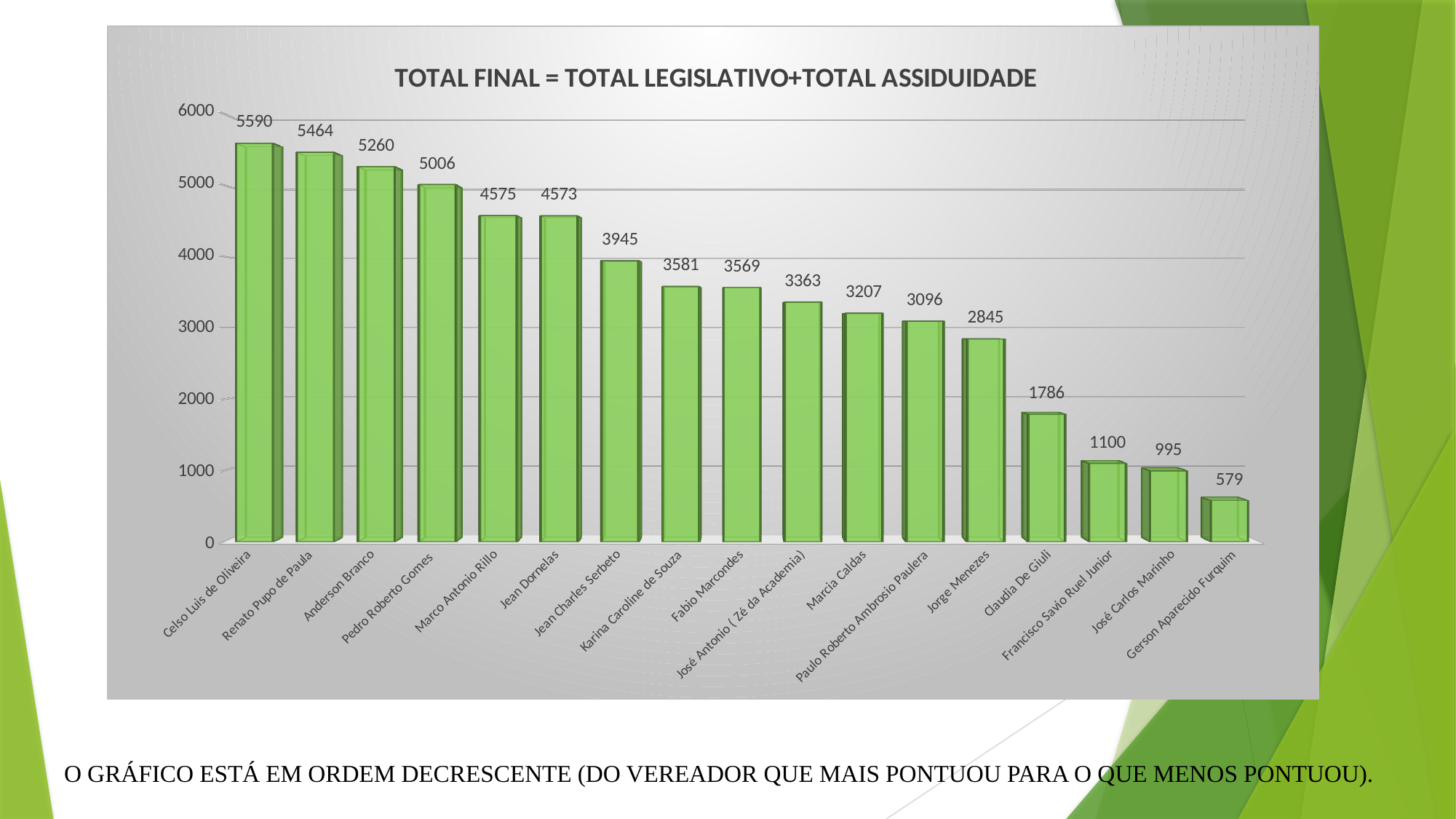
What is the value for Claudia De Giuli? 1786 What kind of chart is shown on the slide? bar chart How many categories are shown on the x axis? 17 Which is larger, the value for Anderson Branco or the value for Pedro Roberto Gomes? Anderson Branco What is the difference between the values for Jorge Menezes and Claudia De Giuli? 1059 Is the value for Marcia Caldas greater or less than 3000? greater Which category has the lowest value? Gerson Aparecido Furquim What is the value for Jean Charles Serbeto? 3945 Do the values rise or fall from left to right along the x axis? fall What is the value for Celso Luis de Oliveira? 5590 What is the difference between the values for Celso Luis de Oliveira and Renato Pupo de Paula? 126 Which category has the highest value? Celso Luis de Oliveira